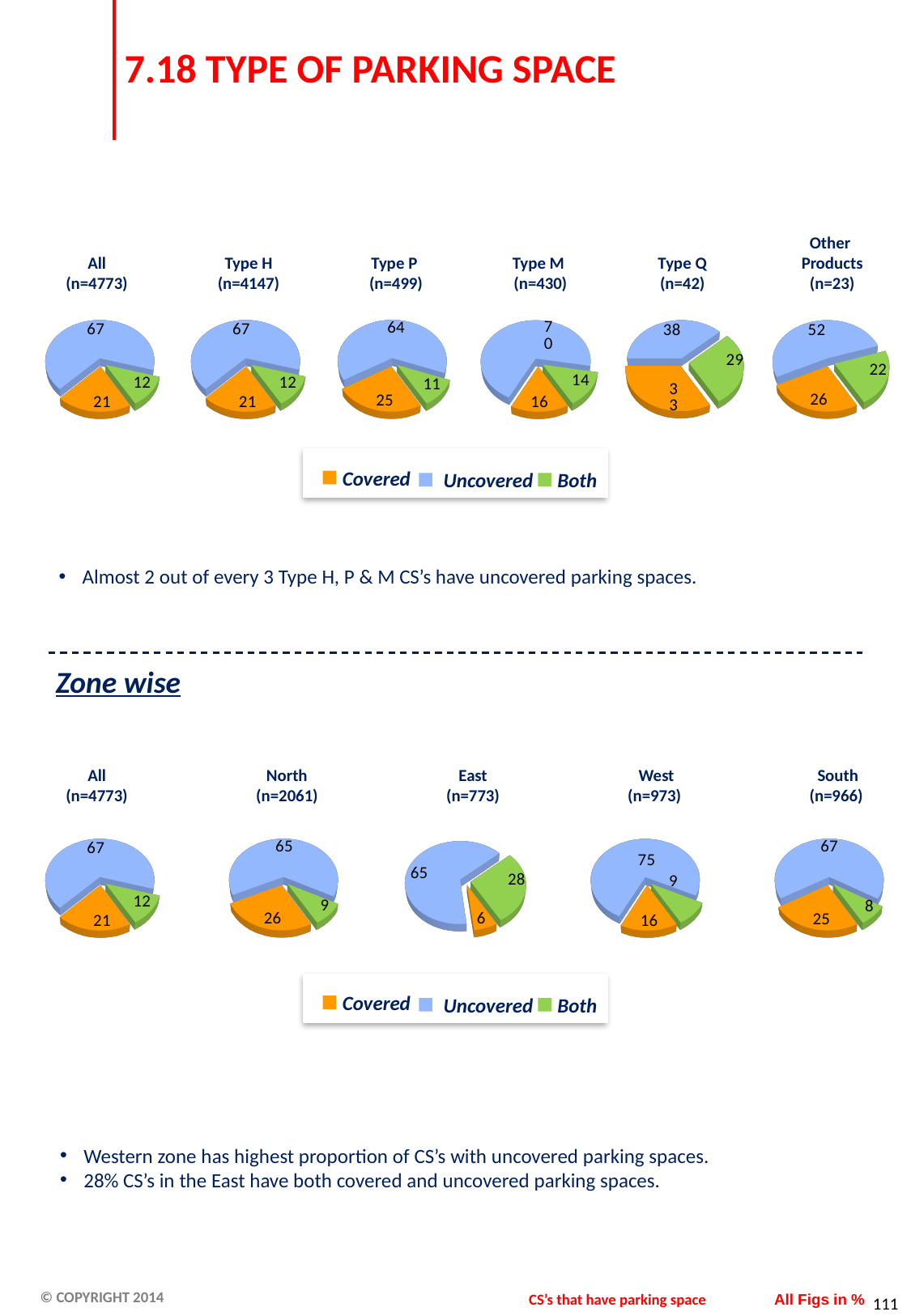
In the 'West (n=973)' pie chart, what is the value for Uncovered? 75 In the 'North (n=2061)' pie chart, which category has the smallest share? Both In the 'South (n=966)' pie chart, what is the difference between the Covered and Both values? 17 In the 'East (n=773)' pie chart in the Zone wise section, what is the value for Covered? 6 How many series does the legend below the top row of pie charts list? 3 What type of chart is used for 'Type H (n=4147)'? Pie chart In the 'Type Q (n=42)' pie chart, which category has the largest share? Uncovered In the top-row 'All (n=4773)' pie chart, what is the value for Uncovered? 67 In the 'Type P (n=499)' pie chart, what is the value for Covered? 25 Which is larger in the 'East (n=773)' pie chart: Both or Covered? Both How many pie charts are shown in the Zone wise section of the slide? 5 In the 'Other Products (n=23)' pie chart, what is the value for Both? 22